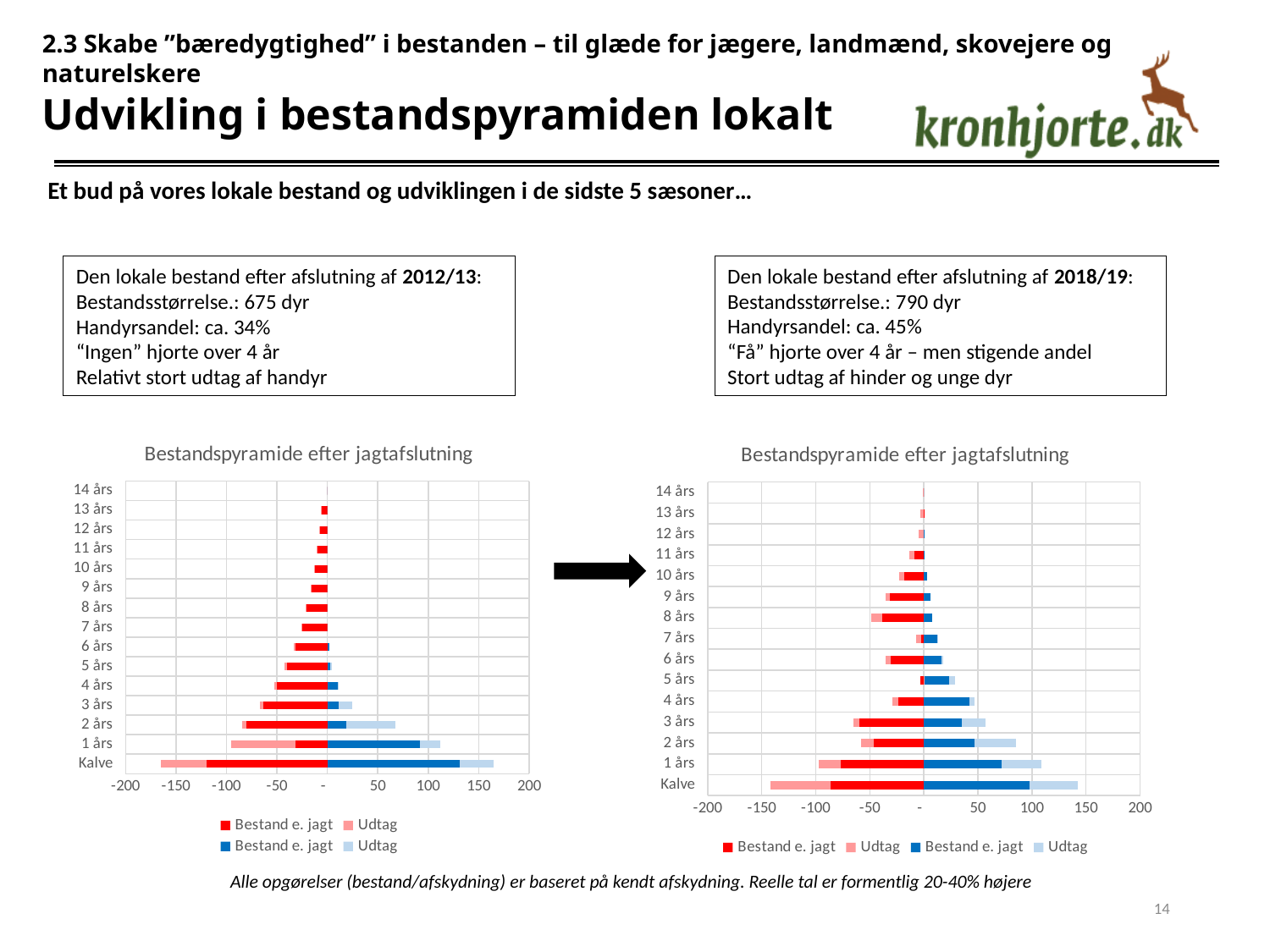
In the left chart, do the bar lengths generally increase or decrease going from Kalve up to 14 års? decrease In the left chart, is the blue "Bestand e. jagt" value for Kalve greater or less than 100? greater In the right chart, is the blue "Bestand e. jagt" value for 3 års greater or less than 50? less In the left chart, which age category has the longest blue "Bestand e. jagt" bar? Kalve In the right chart, which is larger for the blue "Bestand e. jagt" series: Kalve or 1 års? Kalve In the left chart, is the blue "Bestand e. jagt" value for 2 års greater or less than 50? less What is the title of the right chart? Bestandspyramide efter jagtafslutning How many age categories are listed on the vertical axis of the left chart? 15 What is the lowest tick value shown on the horizontal axis of the right chart? -200 How many series does the legend of the right chart list? 4 What kind of chart is the left chart titled "Bestandspyramide efter jagtafslutning"? bar chart